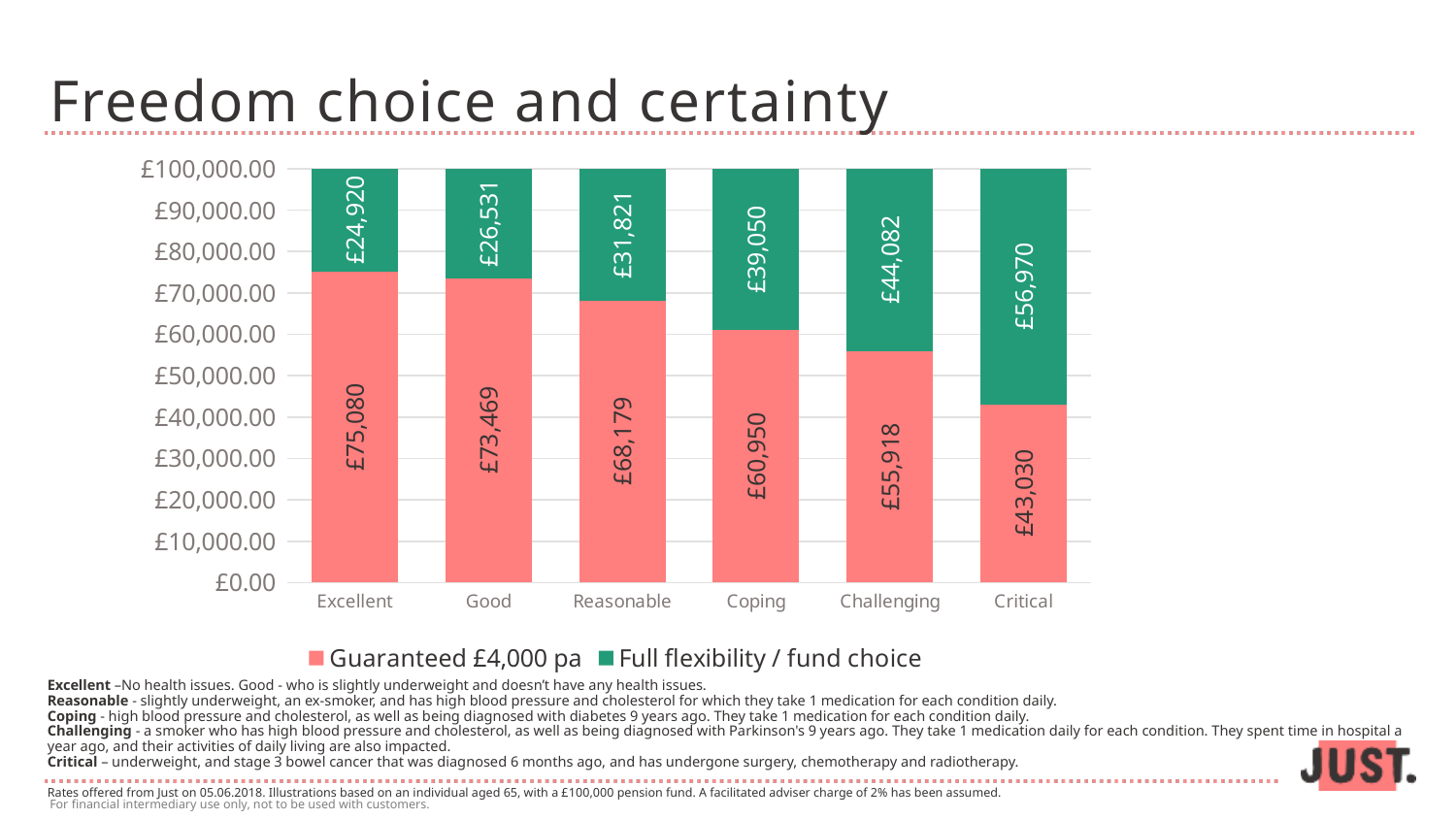
Which category has the highest Full flexibility / fund choice value? Critical How many series does the legend list? 2 What kind of chart is shown on the slide? Stacked bar chart What is the Full flexibility / fund choice value for Critical? £56,970 Which is larger: the Full flexibility / fund choice value for Challenging or for Coping? Challenging How many categories are shown on the x axis? 6 What is the total of the stacked bar for Reasonable? £100,000 Which category has the lowest Guaranteed £4,000 pa value? Critical What is the Guaranteed £4,000 pa value for Coping? £60,950 What is the Guaranteed £4,000 pa value for Excellent? £75,080 Do the Guaranteed £4,000 pa values rise or fall from Excellent to Critical? Fall What is the difference between the Guaranteed £4,000 pa values for Excellent and Good? £1,611